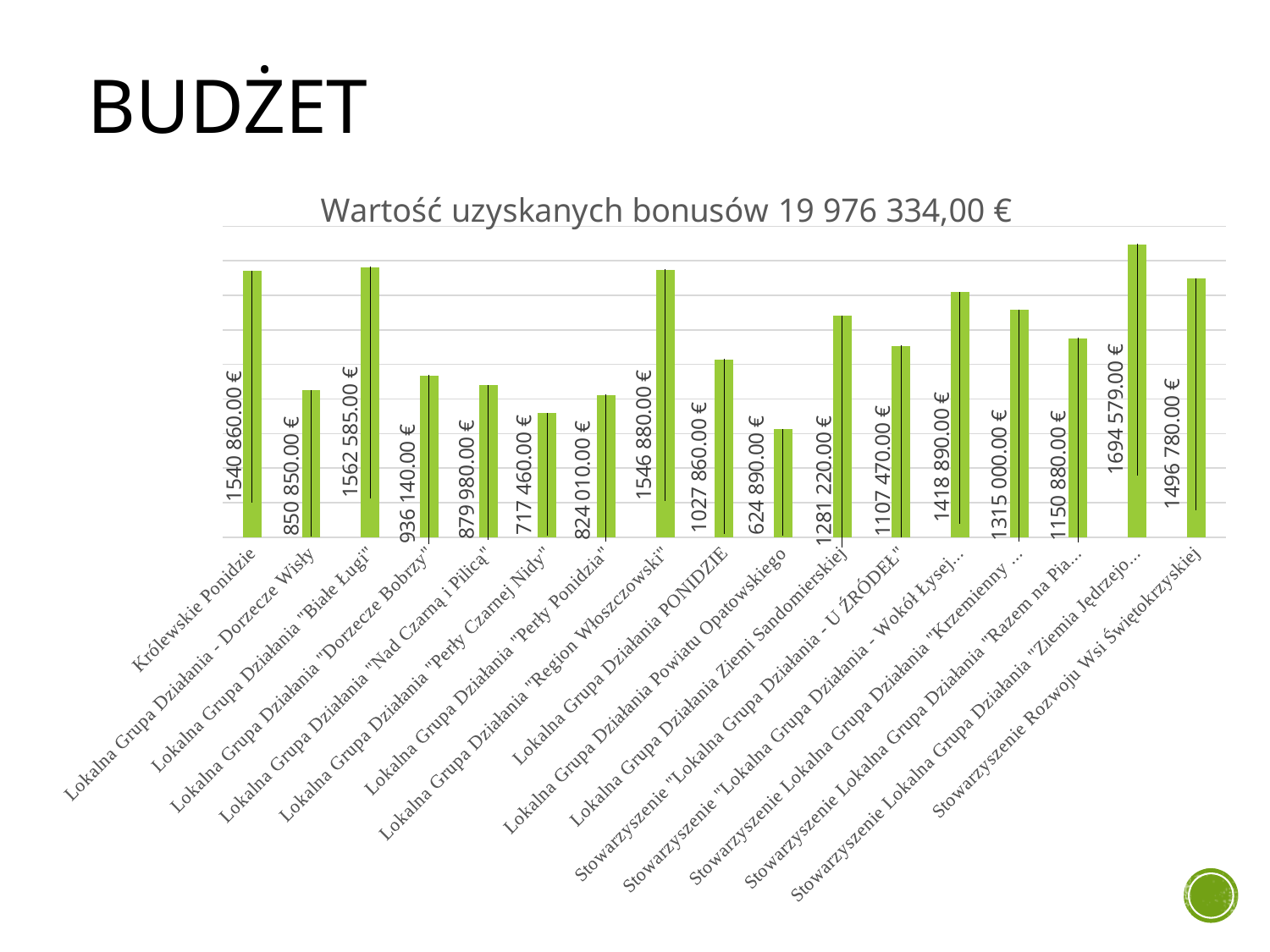
What is the title of the chart? Wartość uzyskanych bonusów 19 976 334,00 € What kind of chart is shown on the slide? Bar chart What is the difference between the values for Lokalna Grupa Działania "Białe Ługi" and Królewskie Ponidzie? 21 725.00 € What is the value for Lokalna Grupa Działania Powiatu Opatowskiego? 624 890.00 € What is the value for Lokalna Grupa Działania "Perły Czarnej Nidy"? 717 460.00 € What is the difference between the values for Lokalna Grupa Działania "Dorzecze Bobrzy" and Lokalna Grupa Działania - Dorzecze Wisły? 85 290.00 € Which category has the highest value? Stowarzyszenie Lokalna Grupa Działania "Ziemia Jędrzejo..." What is the value for Stowarzyszenie Rozwoju Wsi Świętokrzyskiej? 1 496 780.00 € What is the value for Królewskie Ponidzie? 1 540 860.00 € Which is larger, the value for Lokalna Grupa Działania Ziemi Sandomierskiej or the value for Lokalna Grupa Działania PONIDZIE? Lokalna Grupa Działania Ziemi Sandomierskiej Which category has the lowest value? Lokalna Grupa Działania Powiatu Opatowskiego How many categories are shown in the chart? 17